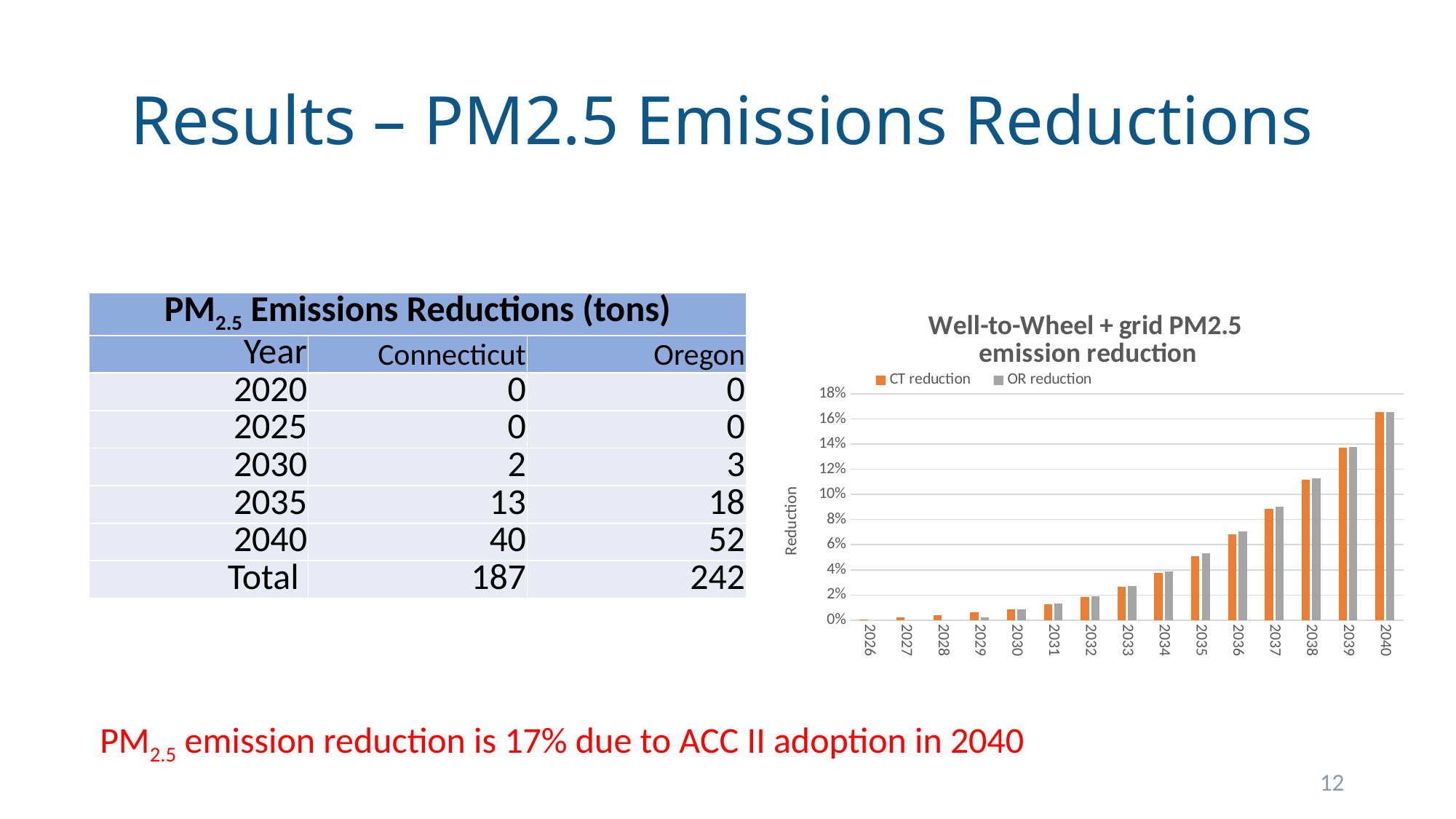
Is the OR reduction for 2035 greater or less than 4%? greater How many series does the legend of the chart list? 2 Is the CT reduction for 2040 greater or less than 14%? greater Do the reduction values rise or fall from 2026 to 2040 in the chart? rise Is the CT reduction for 2030 greater or less than 2%? less Which year has the highest CT reduction in the chart? 2040 What is the title of the chart? Well-to-Wheel + grid PM2.5 emission reduction What kind of chart is shown on the slide? bar chart In 2029, which is larger in the chart: CT reduction or OR reduction? CT reduction How many years are shown on the x axis of the chart? 15